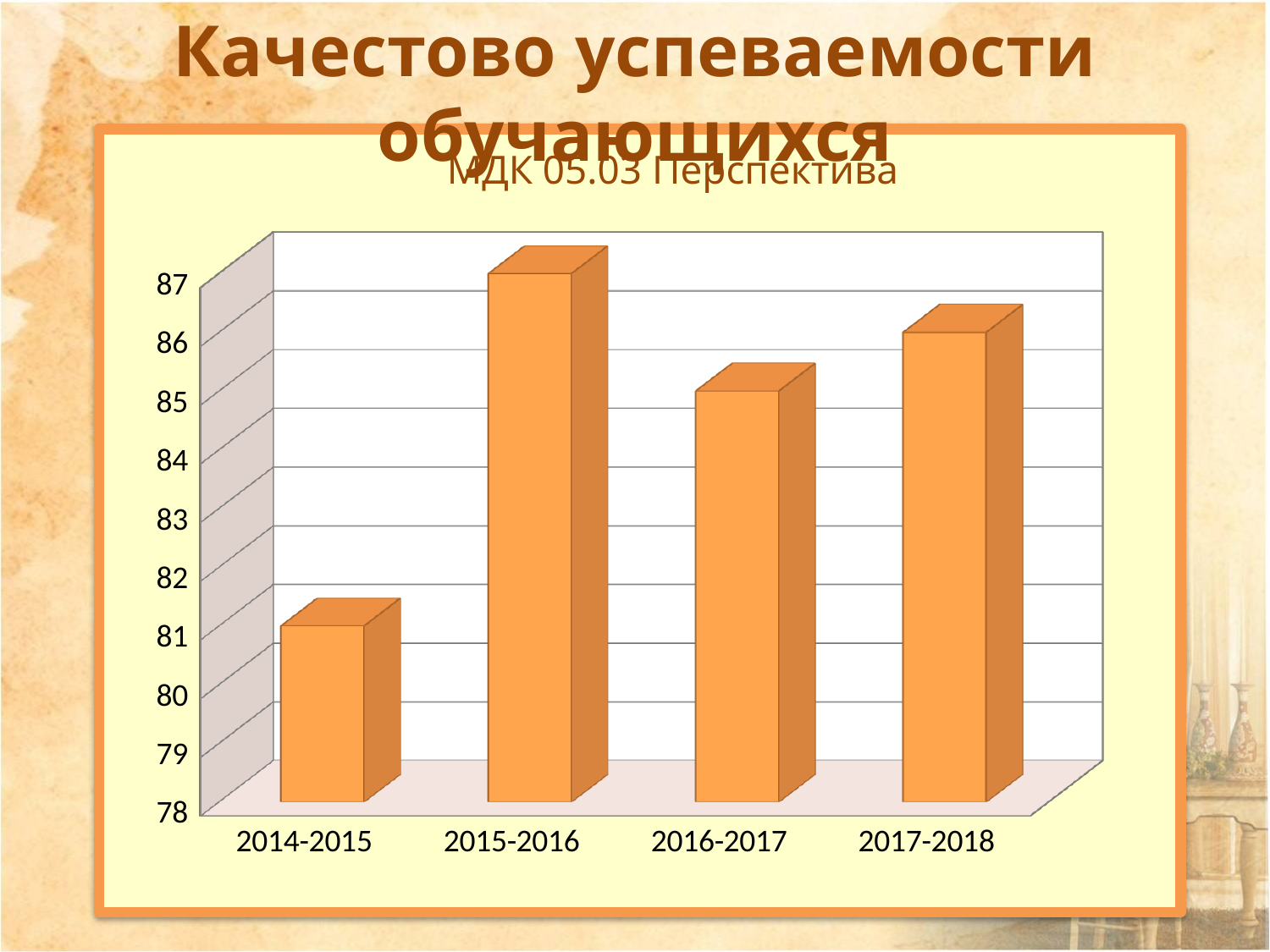
Is the value for 2015-2016 greater or less than 86? greater Which is larger, the value for 2014-2015 or the value for 2016-2017? 2016-2017 Does the value rise or fall from 2015-2016 to 2016-2017? fall Which academic year has the highest bar in the chart? 2015-2016 Is the value for 2017-2018 greater or less than 87? less How many academic years are shown on the x axis of the chart? 4 Is the value for 2014-2015 greater or less than 82? less Which is larger, the value for 2016-2017 or the value for 2017-2018? 2017-2018 What kind of chart is shown on the slide? bar chart What is the title printed above the chart's plot area? МДК 05.03 Перспектива Which academic year has the lowest bar in the chart? 2014-2015